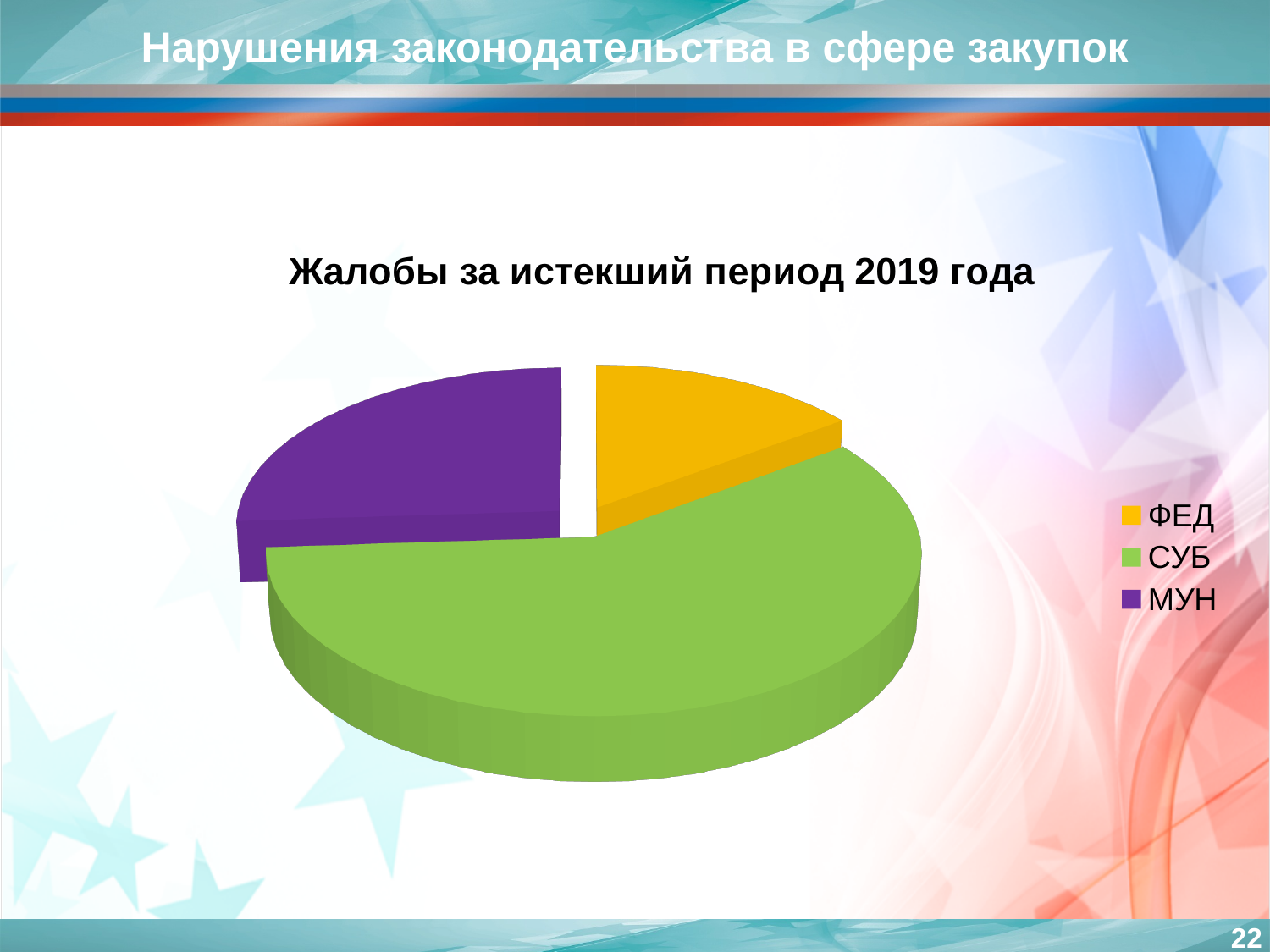
Which slice is larger, СУБ or МУН? СУБ Which slice is larger, МУН or ФЕД? МУН What is the title of the chart? Жалобы за истекший период 2019 года Which category is shown in purple? МУН How many slices does the pie chart have? 3 Which slice is larger, ФЕД or СУБ? СУБ How many entries does the legend list? 3 Which category has the smallest slice of the pie? ФЕД What kind of chart is shown on the slide? Pie chart What colour is the slice for СУБ? Green Which category has the largest slice of the pie? СУБ